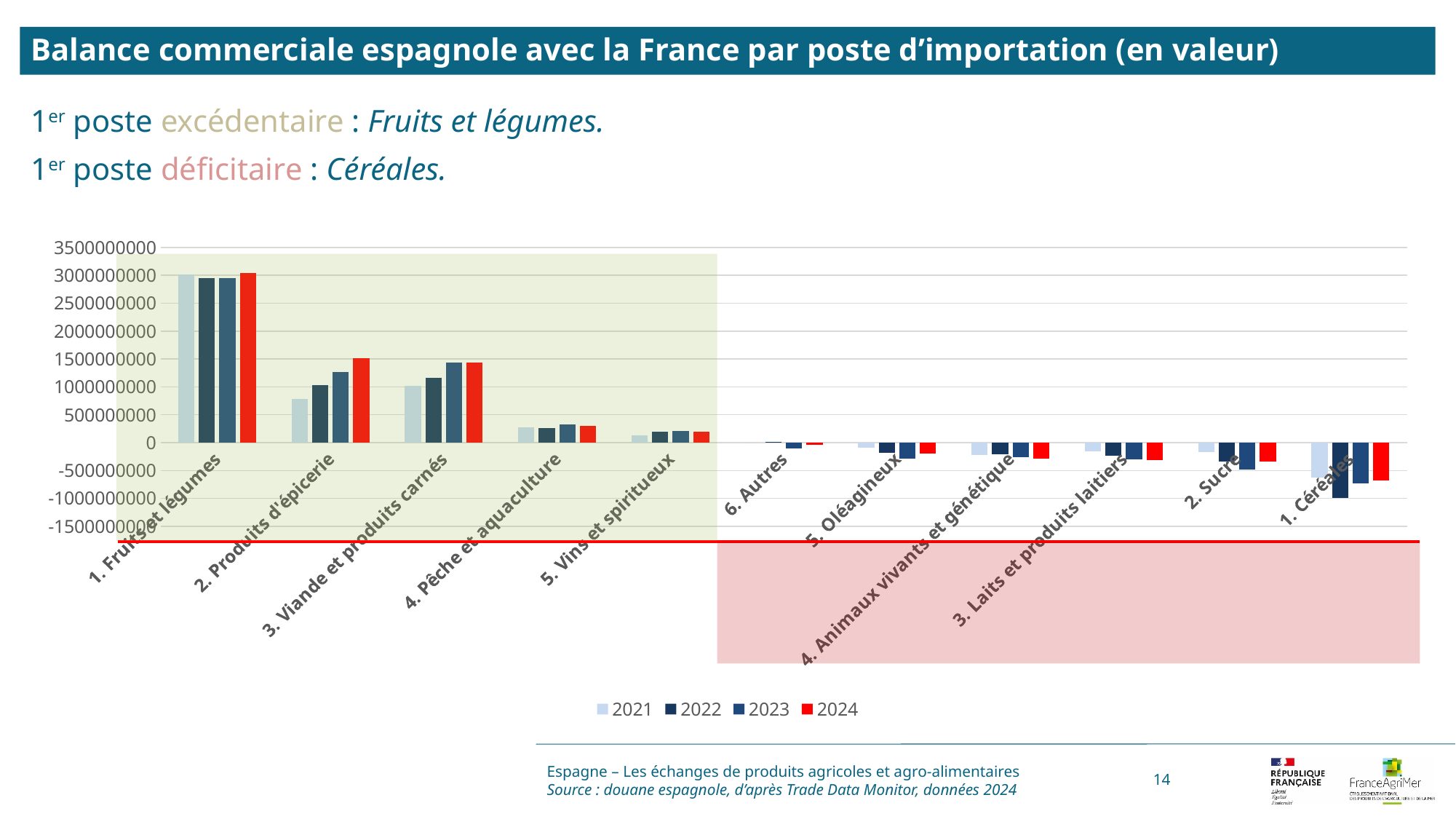
Is the 2021 value for 2. Produits d'épicerie greater or less than 1000000000? less How many series does the legend list? 4 For 2. Produits d'épicerie, do the values rise or fall from 2021 to 2024? rise Is the 2024 value for 1. Céréales greater or less than -500000000? less Which category has the lowest (most negative) values in the chart? 1. Céréales What kind of chart is shown on the slide? bar chart Which year is listed first in the chart legend? 2021 How many categories are shown on the x axis of the chart? 11 Is the 2024 value for 1. Fruits et légumes greater or less than 2500000000? greater Which is larger, the 2024 value for 1. Fruits et légumes or the 2024 value for 2. Produits d'épicerie? 1. Fruits et légumes Which category has the highest values in the chart? 1. Fruits et légumes Which colour represents the 2024 series in the legend? red